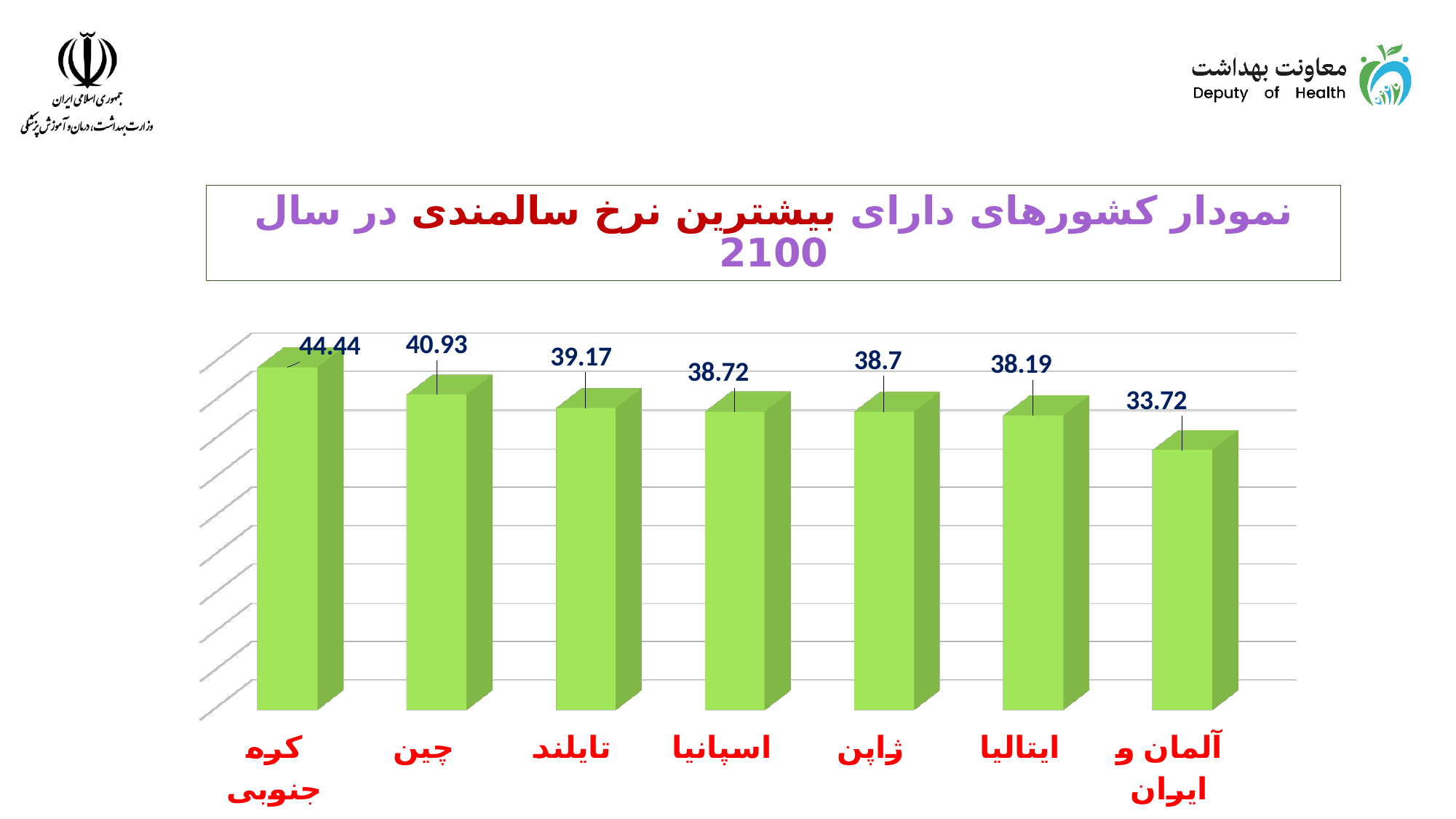
What is the value for چین (China)? 40.93 What is the difference between the values for ایتالیا and آلمان و ایران? 4.47 Which category has the highest value? کره جنوبی What is the value for کره جنوبی (South Korea)? 44.44 Which category has the lowest value? آلمان و ایران How many countries (categories) are shown in the chart? 7 Which is larger, the value for تایلند or the value for ایتالیا? تایلند What is the difference between the values for کره جنوبی and چین? 3.51 What type of chart is shown on the slide? bar chart Do the values rise or fall moving from left to right along the x axis? fall What is the value for ژاپن (Japan)? 38.7 What is the value for آلمان و ایران (Germany and Iran)? 33.72